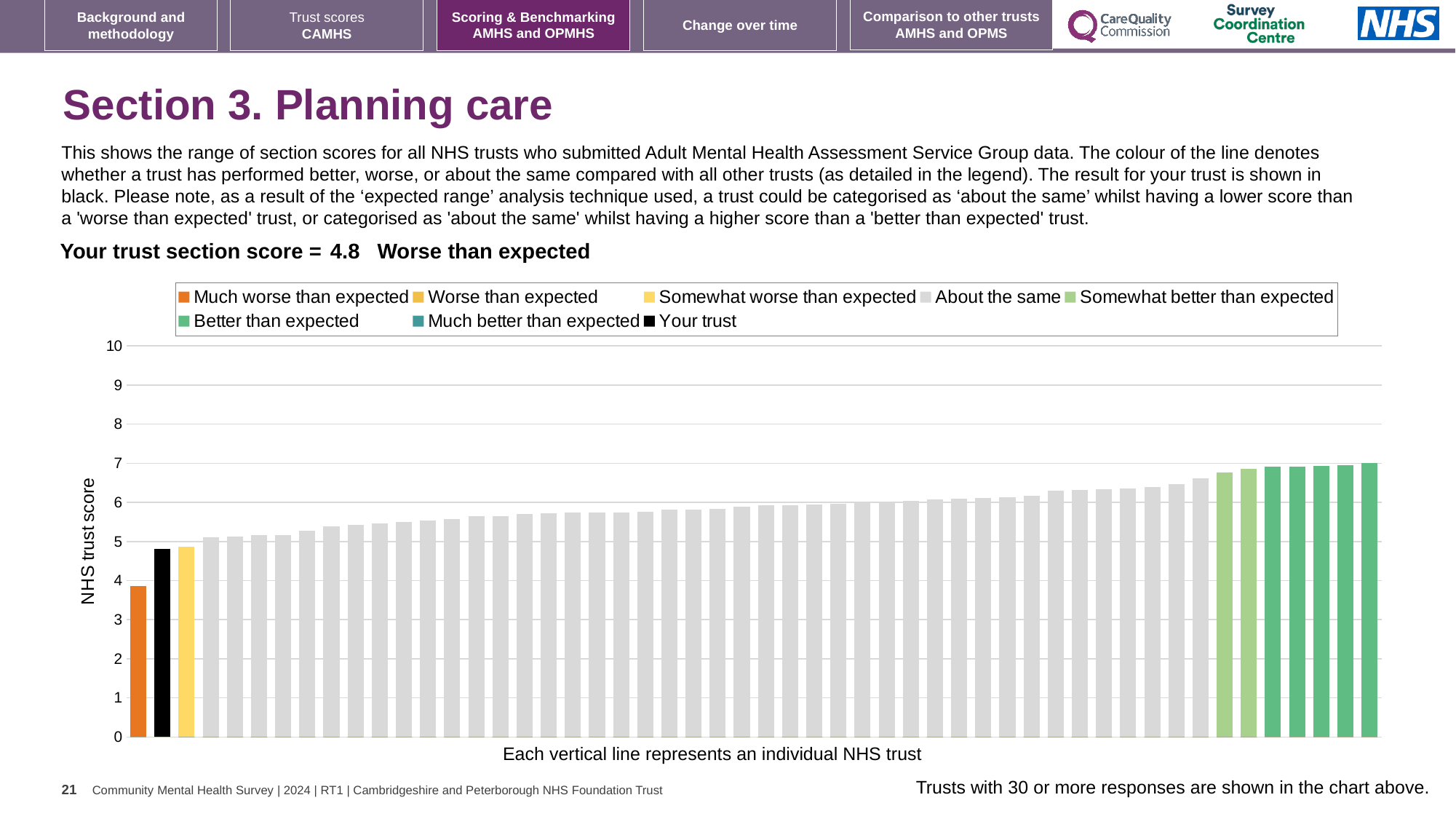
Which legend category does the lowest bar in the chart belong to? Much worse than expected What is the section score for your trust? 4.8 How many entries does the chart legend list? 8 Is the value of the tallest bar greater or less than 6? greater Which category is your trust placed in for this section? Worse than expected What kind of chart is shown on the slide? bar chart Is the value of the orange 'Much worse than expected' bar greater or less than 5? less Is the value for your trust greater or less than 5? less Do the bar values rise or fall from left to right across the chart? rise Which legend category does the highest bar in the chart belong to? Better than expected What is the label on the vertical axis of the chart? NHS trust score Is the bar for your trust higher or lower than the orange 'Much worse than expected' bar? higher